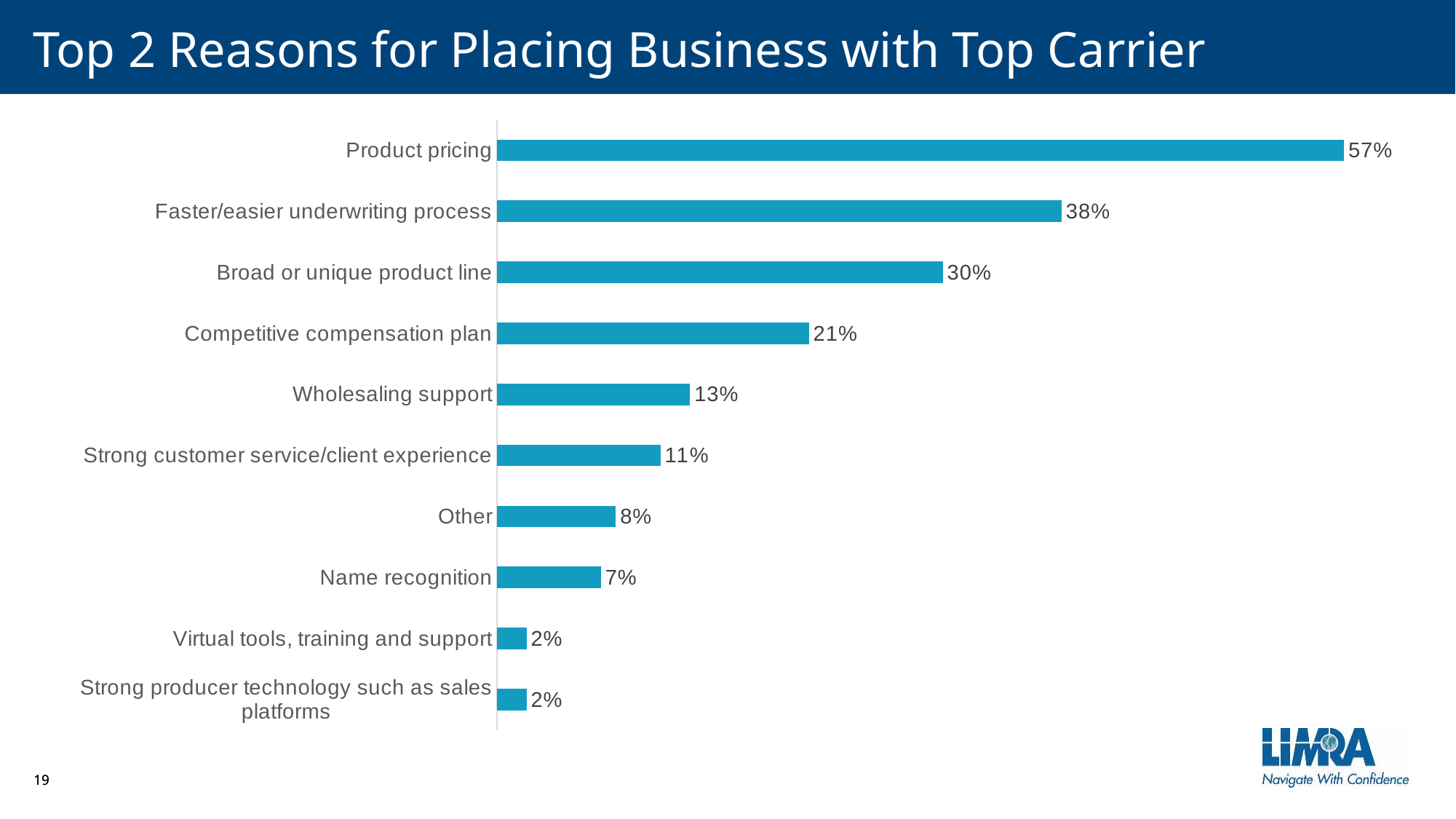
How many reasons (categories) are shown in the chart? 10 Which is larger, Other or Name recognition? Other What percentage is shown for Product pricing? 57% What is the title of the slide? Top 2 Reasons for Placing Business with Top Carrier What is the difference between Product pricing and Faster/easier underwriting process? 19% Which is larger, Wholesaling support or Strong customer service/client experience? Wholesaling support What type of chart is shown on the slide? Bar chart What is the difference between Broad or unique product line and Competitive compensation plan? 9% What percentage is shown for Wholesaling support? 13% What value is shown for Faster/easier underwriting process? 38% Which reason has the highest percentage? Product pricing What value is shown for Name recognition? 7%